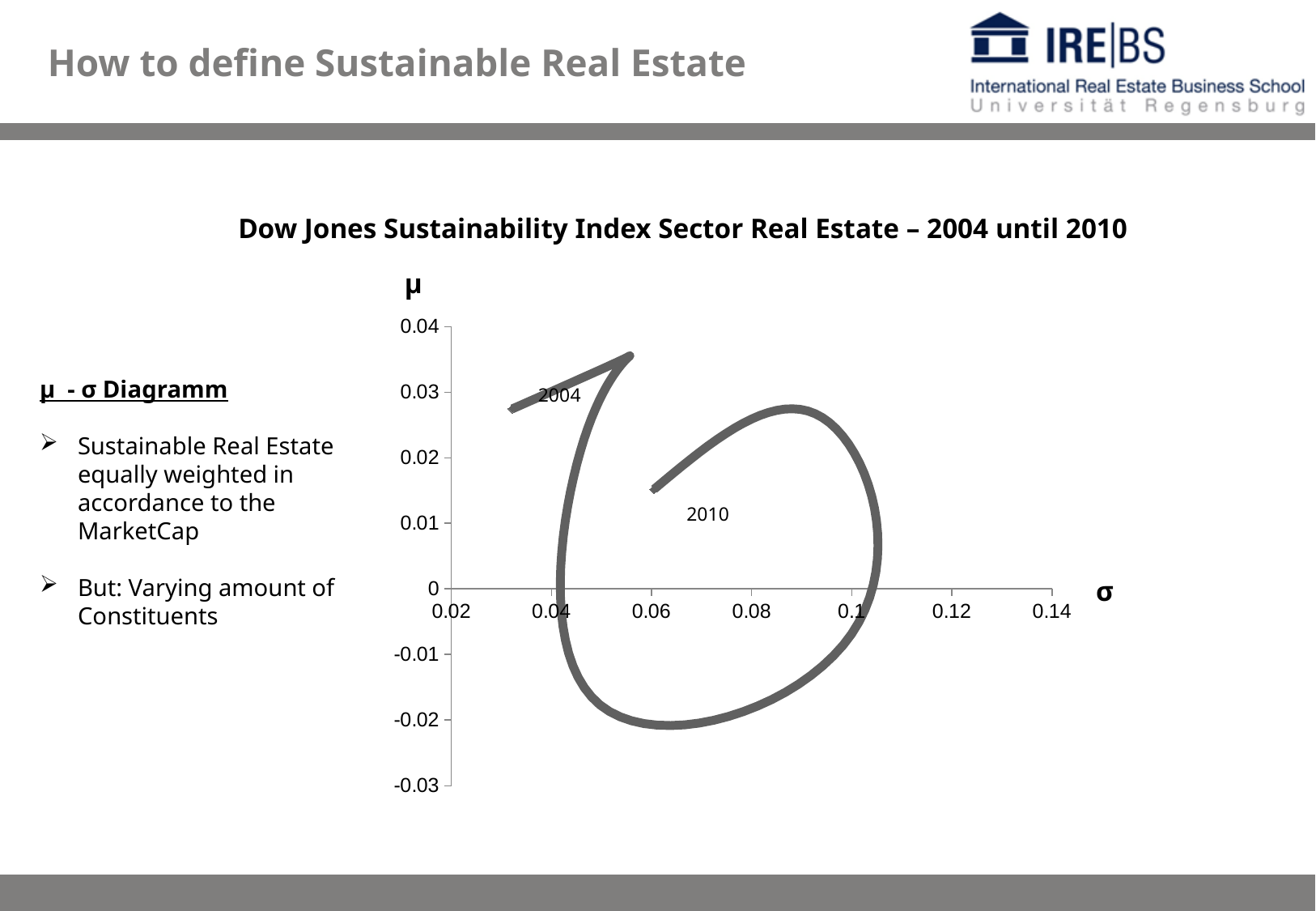
Which symbol labels the vertical axis of the chart? μ What kind of chart is shown on the slide? line chart Is the σ value for the point labelled 2010 greater or less than 0.04? greater Which labelled point has the higher σ value, 2004 or 2010? 2010 How many points on the curve are labelled with a year? 2 What is the title of the chart? Dow Jones Sustainability Index Sector Real Estate – 2004 until 2010 Is the σ value for the point labelled 2004 greater or less than 0.04? less Does the μ value fall or rise from the 2004 point to the 2010 point? fall Is the highest μ value reached by the curve greater or less than 0.03? greater Which labelled point has the higher μ value, 2004 or 2010? 2004